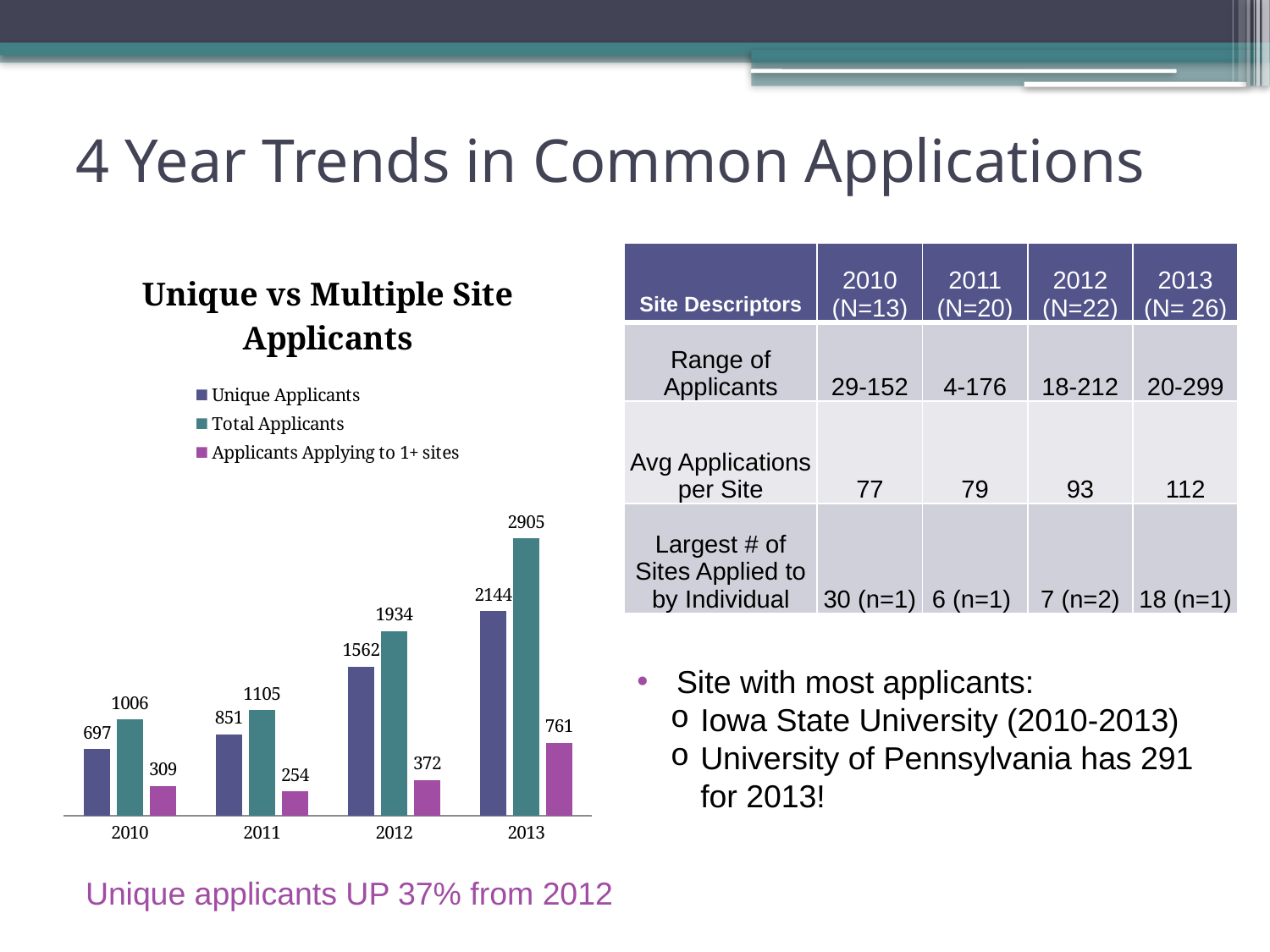
What is the value for Applicants Applying to 1+ sites in 2011? 254 How many years are shown on the x axis of the chart? 4 How many series does the chart legend list? 3 What is the value for Total Applicants in 2013? 2905 What is the difference between Total Applicants and Unique Applicants in 2012? 372 Which year has the lowest value for Applicants Applying to 1+ sites? 2011 What kind of chart is shown on the slide? Bar chart Which year has the highest value for Unique Applicants? 2013 What is the title of the chart? Unique vs Multiple Site Applicants What is the value for Unique Applicants in 2010? 697 Which is larger: Unique Applicants in 2012 or Total Applicants in 2011? Unique Applicants in 2012 Do the Total Applicants values rise or fall from 2010 to 2013? Rise